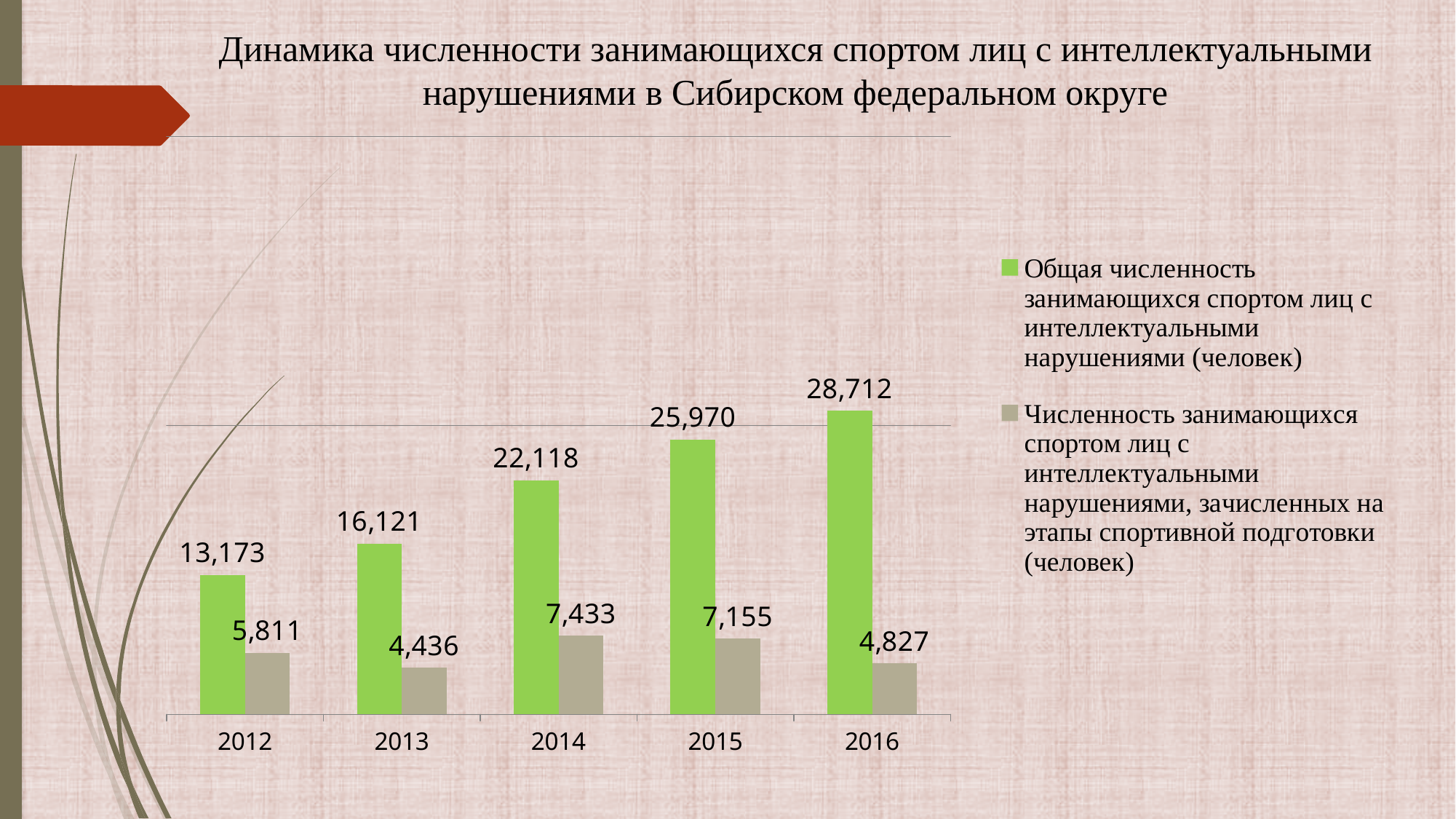
How many years are shown on the x axis of the chart? 5 In which year is the number enrolled in sports training stages (grey series) the lowest? 2013 What kind of chart is shown on the slide? Bar chart What colour represents the series 'Общая численность занимающихся спортом лиц с интеллектуальными нарушениями (человек)'? Green Does the total number of people engaged in sport (green series) rise or fall from 2012 to 2016? Rise In which year is the total number of people engaged in sport (green series) the highest? 2016 Which is larger: the number enrolled in training stages in 2014 or in 2015? 2014 What is the number of people enrolled in sports training stages (Численность ... зачисленных на этапы спортивной подготовки) in 2013? 4,436 How many series does the legend list? 2 What is the difference between the total number engaged in sport in 2016 and in 2012? 15,539 What is the value of the green series (Общая численность) for 2016? 28,712 What is the total number of people with intellectual disabilities engaged in sport (Общая численность) in 2014? 22,118